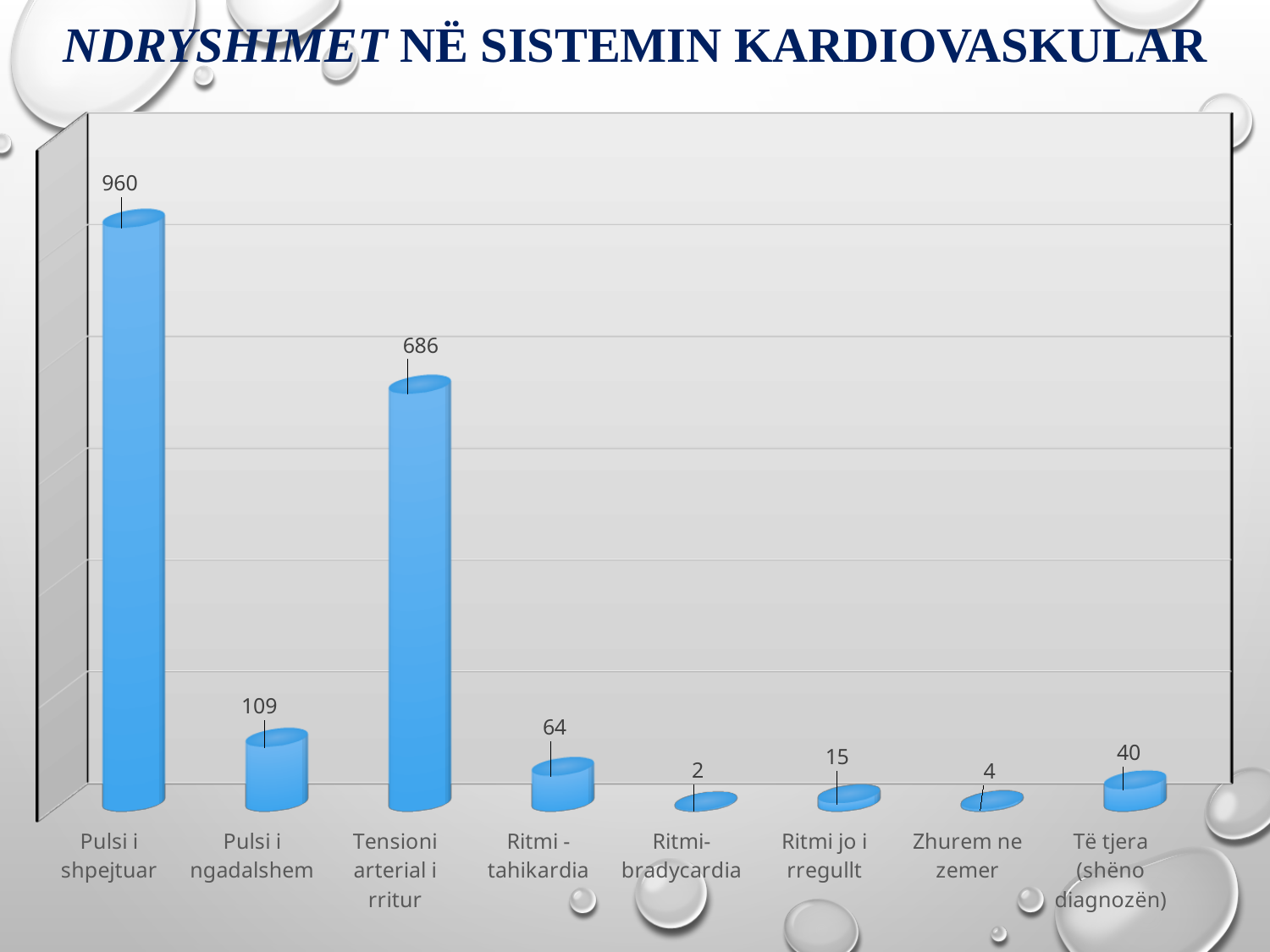
What is the difference between the values for Pulsi i ngadalshem and Ritmi - tahikardia? 45 What is the value for Tensioni arterial i rritur? 686 What is the difference between the values for Pulsi i shpejtuar and Tensioni arterial i rritur? 274 Which category has the highest value? Pulsi i shpejtuar What is the title of the slide? NDRYSHIMET NË SISTEMIN KARDIOVASKULAR How many categories are shown in the chart? 8 Which category has the lowest value? Ritmi- bradycardia Which is larger, the value for Ritmi jo i rregullt or the value for Zhurem ne zemer? Ritmi jo i rregullt What is the value for Të tjera (shëno diagnozën)? 40 What kind of chart is shown on the slide? Bar chart What is the value for Ritmi - tahikardia? 64 What is the value for Pulsi i shpejtuar? 960